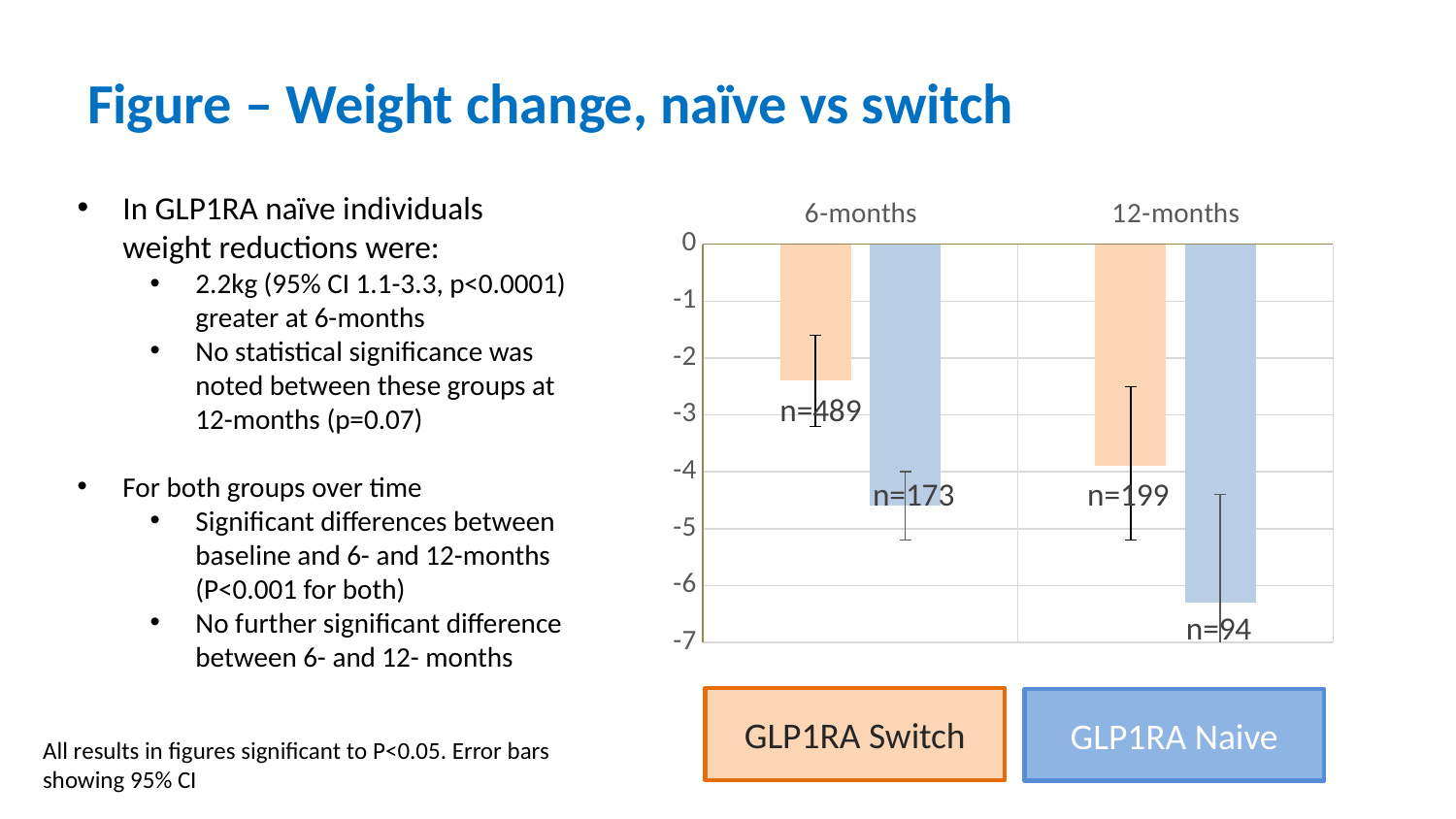
Is the value for GLP1RA Switch at 6-months greater or less than -3? greater Which bar reaches the lowest value on the chart? GLP1RA Naive at 12-months What is the n value labelled on the GLP1RA Switch bar at 12-months? n=199 What is the n value labelled on the GLP1RA Switch bar at 6-months? n=489 What kind of chart is shown on the slide? bar chart Which colour represents the GLP1RA Switch series? orange How many series does the legend list? 2 What is the n value labelled on the GLP1RA Naive bar at 6-months? n=173 Is the value for GLP1RA Naive at 12-months greater or less than -6? less How many time-point categories are shown on the x axis? 2 What is the n value labelled on the GLP1RA Naive bar at 12-months? n=94 At 6-months, which group shows the larger weight reduction, GLP1RA Switch or GLP1RA Naive? GLP1RA Naive